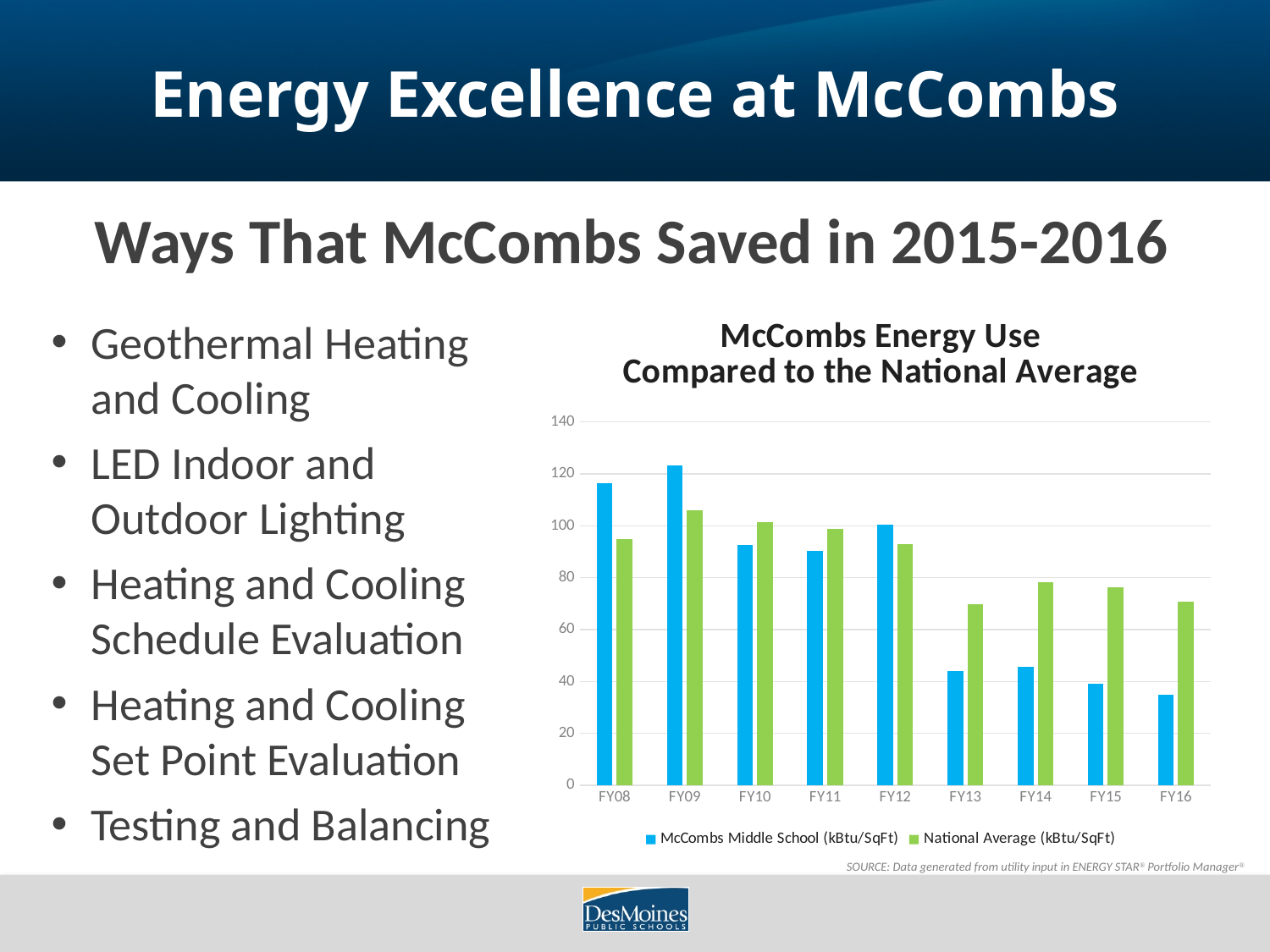
In FY13, which is larger: the McCombs Middle School value or the National Average value? National Average What kind of chart is shown on the slide? bar chart Is the McCombs Middle School value for FY09 greater or less than 120? greater In which fiscal year is the McCombs Middle School value lowest? FY16 How many fiscal years are shown on the x axis of the chart? 9 Is the McCombs Middle School value for FY16 greater or less than 40? less In FY08, which is larger: the McCombs Middle School value or the National Average value? McCombs Middle School In which fiscal year is the McCombs Middle School value highest? FY09 How many series does the chart legend list? 2 Overall, do the McCombs Middle School values rise or fall from FY08 to FY16? fall Is the National Average value for FY14 greater or less than 80? less What is the title of the chart? McCombs Energy Use Compared to the National Average